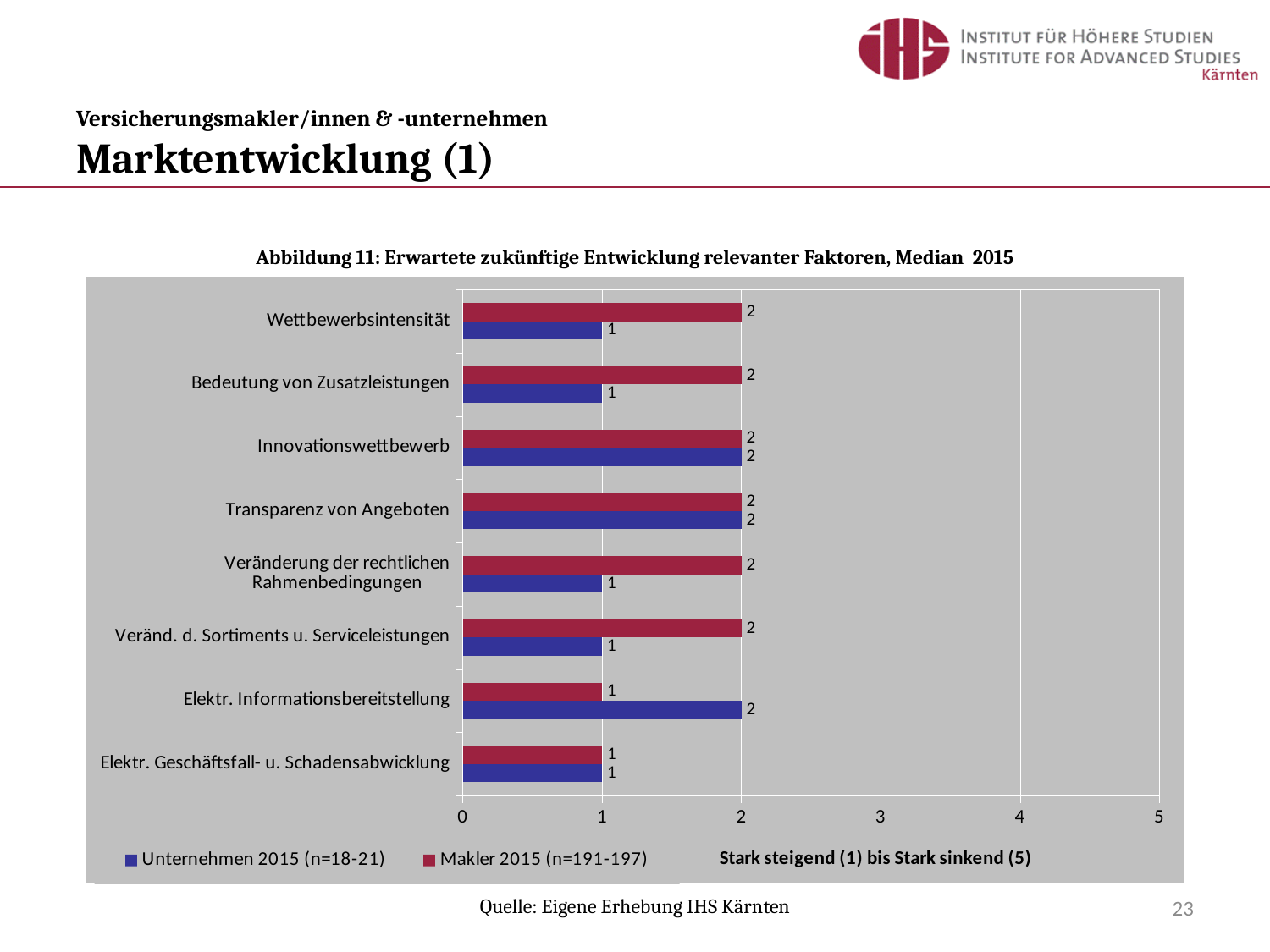
What is the value for Unternehmen 2015 for Wettbewerbsintensität? 1 For Elektr. Informationsbereitstellung, which series has the larger value, Unternehmen 2015 or Makler 2015? Unternehmen 2015 What kind of chart is shown on the slide? Bar chart What is the value for Makler 2015 for Wettbewerbsintensität? 2 For Veränderung der rechtlichen Rahmenbedingungen, which series has the larger value, Unternehmen 2015 or Makler 2015? Makler 2015 What is the value for Unternehmen 2015 for Elektr. Informationsbereitstellung? 2 What is the title of the chart? Abbildung 11: Erwartete zukünftige Entwicklung relevanter Faktoren, Median 2015 How many series does the legend list? 2 What is the value for Makler 2015 for Elektr. Geschäftsfall- u. Schadensabwicklung? 1 What is the value for Unternehmen 2015 for Innovationswettbewerb? 2 What is the difference between the Makler 2015 and Unternehmen 2015 values for Bedeutung von Zusatzleistungen? 1 How many categories are shown on the chart? 8